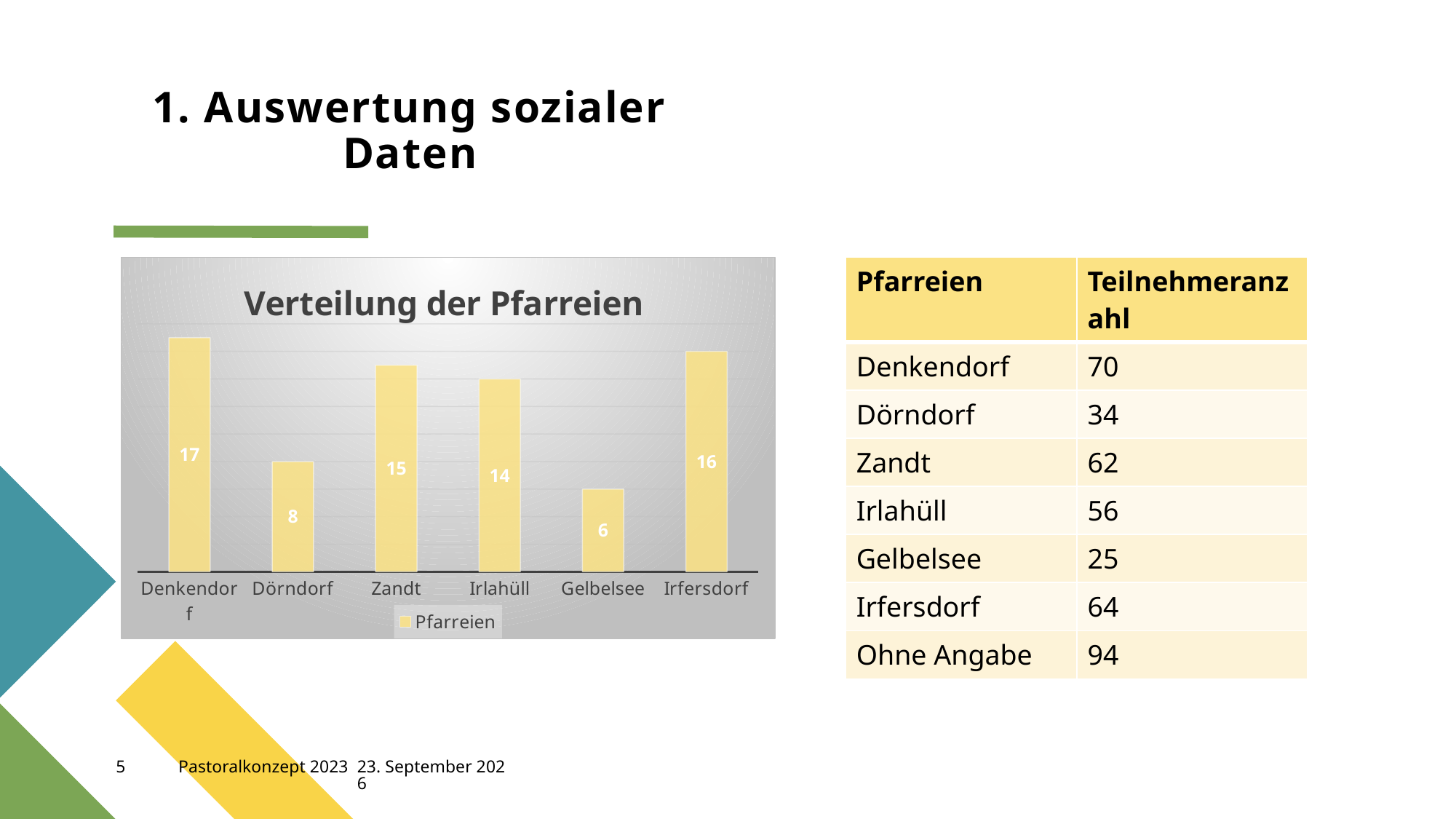
Which category has the lowest value in the chart? Gelbelsee Which category has the highest value in the chart? Denkendorf How many categories are shown in the chart? 6 What kind of chart is shown on the slide? Bar chart In the chart, what is the value for Denkendorf? 17 In the chart, what is the difference between the values for Denkendorf and Dörndorf? 9 What is the title of the chart? Verteilung der Pfarreien In the chart, what is the difference between the values for Irfersdorf and Zandt? 1 In the chart, what is the value for Irlahüll? 14 How many series does the chart legend list? 1 In the chart, which is larger: the value for Zandt or the value for Dörndorf? Zandt In the chart, what is the value for Gelbelsee? 6